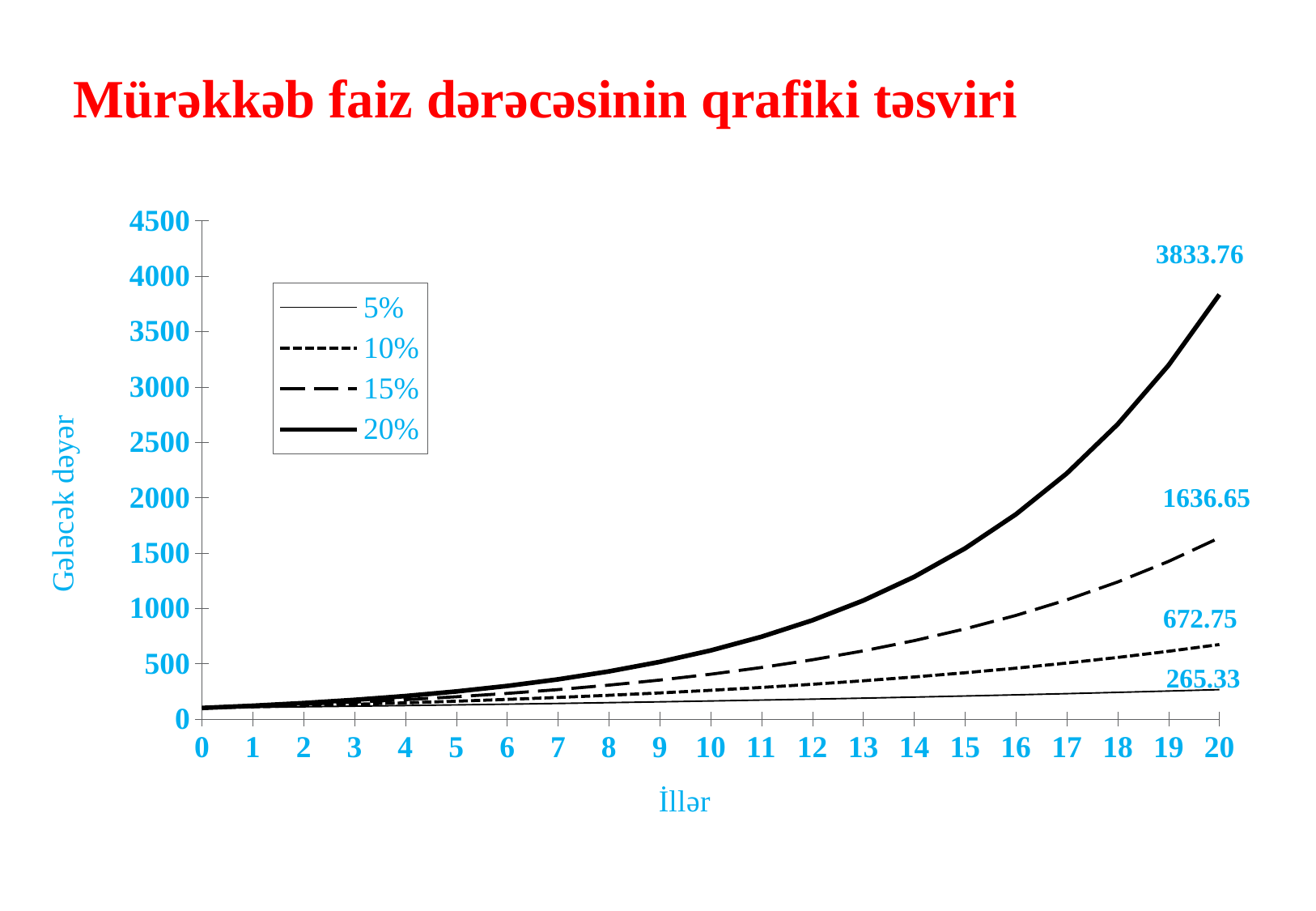
What is the value of the 10% series at year 20? 672.75 How many series does the legend list? 4 What is the title of the chart? Mürəkkəb faiz dərəcəsinin qrafiki təsviri Do the values of the 20% series rise or fall as the years increase? rise What is the value of the 5% series at year 20? 265.33 Which series has the highest value at year 20? 20% Which series has the lowest value at year 20? 5% Is the value of the 20% series at year 14 greater or less than 1000? greater What type of chart is shown on the slide? line chart What is the difference between the 20% and 15% series values at year 20? 2197.11 What is the value of the 20% series at year 20? 3833.76 What is the value of the 15% series at year 20? 1636.65